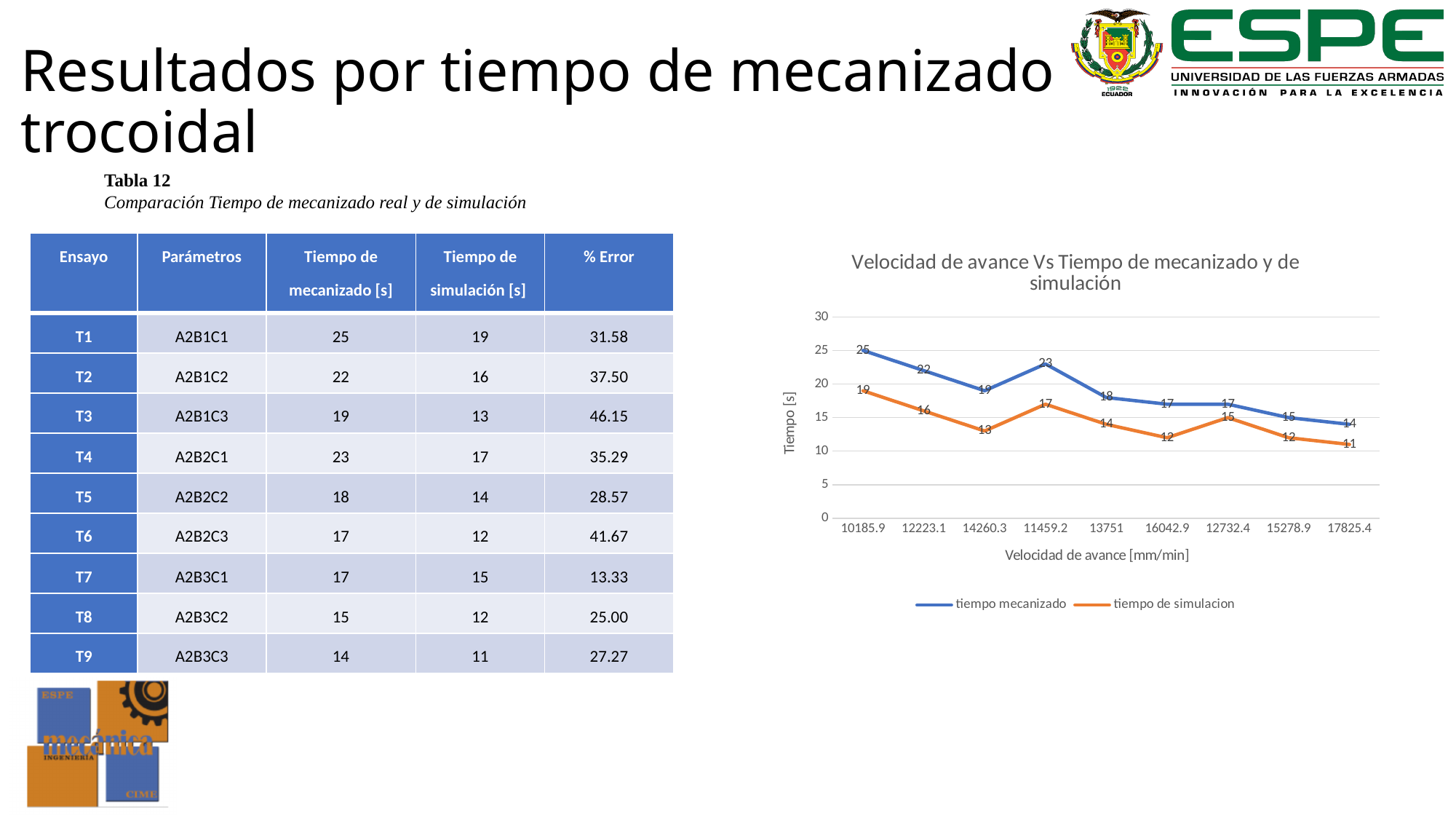
What is the value of tiempo mecanizado at a feed rate of 11459.2 mm/min? 23 Overall, does tiempo mecanizado rise or fall from left to right along the x axis? fall At which feed rate is tiempo mecanizado highest? 10185.9 What is the title of the chart? Velocidad de avance Vs Tiempo de mecanizado y de simulación How many series does the chart legend list? 2 What is the value of tiempo mecanizado at a feed rate of 10185.9 mm/min? 25 At which feed rate is tiempo de simulacion lowest? 17825.4 Which is larger at 12732.4 mm/min: tiempo mecanizado or tiempo de simulacion? tiempo mecanizado How many feed-rate categories are plotted along the x axis of the chart? 9 What kind of chart is shown on the slide? line chart What is the difference between tiempo mecanizado and tiempo de simulacion at 12223.1 mm/min? 6 What is the value of tiempo de simulacion at a feed rate of 14260.3 mm/min? 13